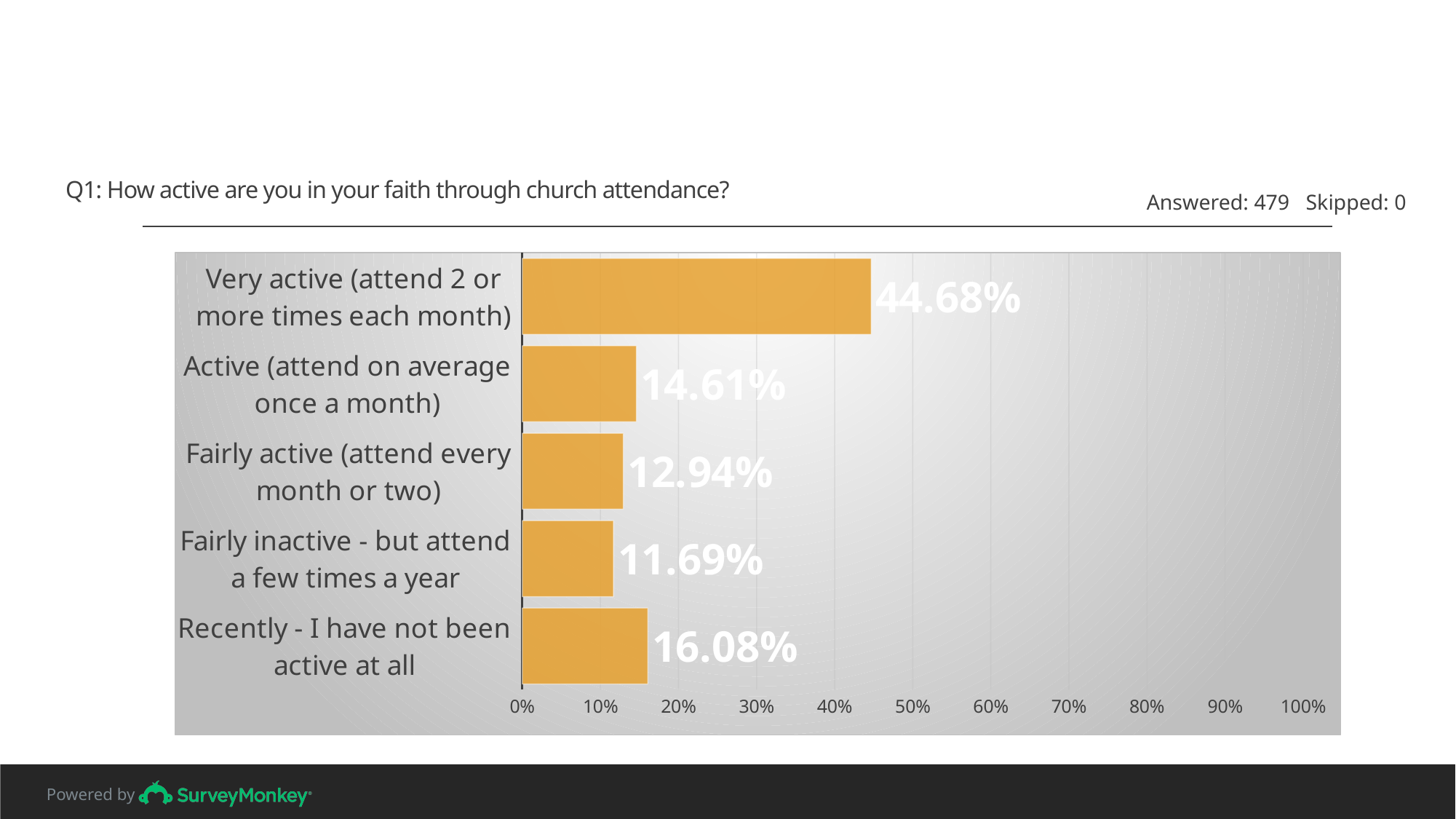
Which response category has the highest percentage? Very active (attend 2 or more times each month) What kind of chart is shown on the slide? Bar chart What percentage of respondents said they are active (attend on average once a month)? 14.61% What is the difference in percentage points between the very active category and the active (once a month) category? 30.07 What percentage of respondents said they are very active (attend 2 or more times each month)? 44.68% What percentage of respondents said they have recently not been active at all? 16.08% Is the value for very active (attend 2 or more times each month) greater or less than 40%? greater What percentage of respondents said they are fairly inactive but attend a few times a year? 11.69% Which is larger: the percentage for fairly active (attend every month or two) or the percentage for recently not active at all? Recently - I have not been active at all How many people answered the question shown on the slide? 479 How many response categories are shown in the chart? 5 Which response category has the lowest percentage? Fairly inactive - but attend a few times a year